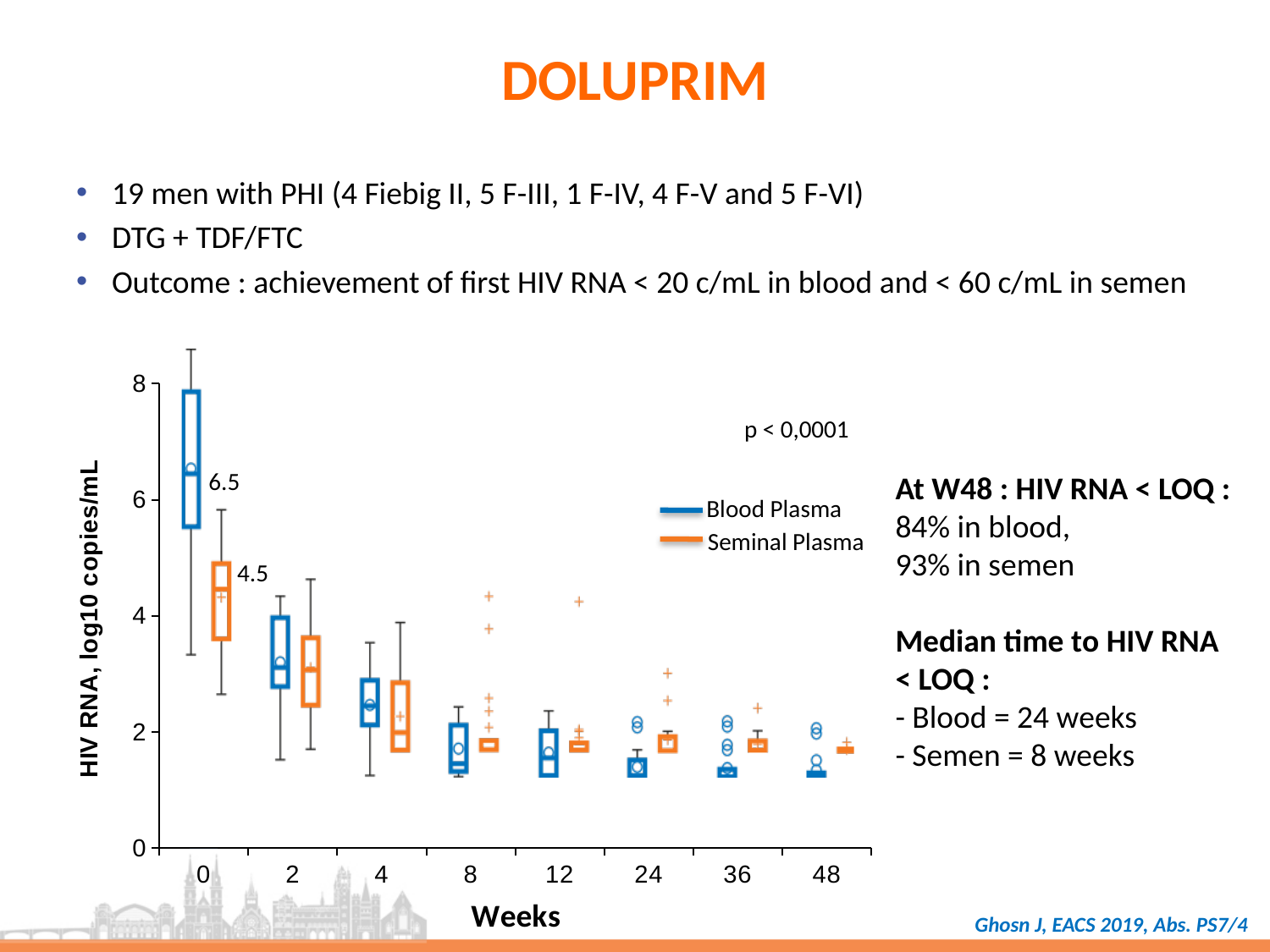
What kind of chart is shown on the slide? Box plot What is the labelled value for Seminal Plasma at week 0? 4.5 Is the Blood Plasma value at week 2 greater or less than 4? less Do the HIV RNA values rise or fall as the weeks increase? Fall What is the label of the y axis? HIV RNA, log10 copies/mL How many time points are shown on the Weeks axis? 8 What is the difference between the labelled Blood Plasma and Seminal Plasma values at week 0? 2 How many series does the legend list? 2 At week 0, which series has the higher labelled value, Blood Plasma or Seminal Plasma? Blood Plasma Is the Blood Plasma value at week 48 greater or less than 2? less What is the labelled value for Blood Plasma at week 0? 6.5 What p-value is printed on the chart? p < 0,0001